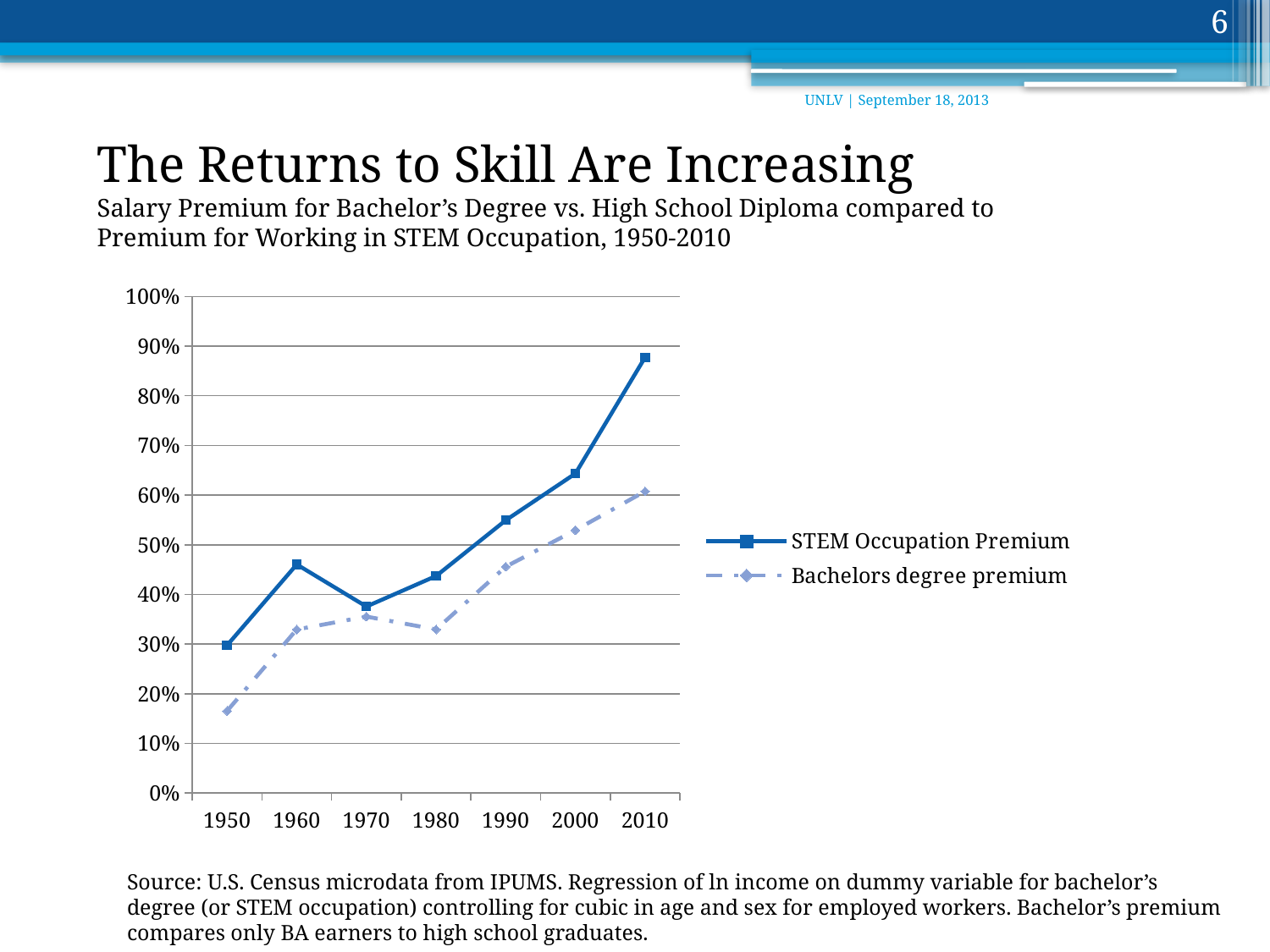
In 2010, which series has the larger value, STEM Occupation Premium or Bachelors degree premium? STEM Occupation Premium Which series is drawn with a dashed line? Bachelors degree premium In which year is the Bachelors degree premium lowest? 1950 Overall, does the Bachelors degree premium rise or fall from 1950 to 2010? Rise What kind of chart is shown on the slide? Line chart How many series does the legend list? 2 Is the Bachelors degree premium in 1980 greater or less than 40%? less Is the STEM Occupation Premium in 2000 greater or less than 60%? greater How many years are plotted along the x axis? 7 In which year is the STEM Occupation Premium highest? 2010 Is the Bachelors degree premium in 1950 greater or less than 20%? less